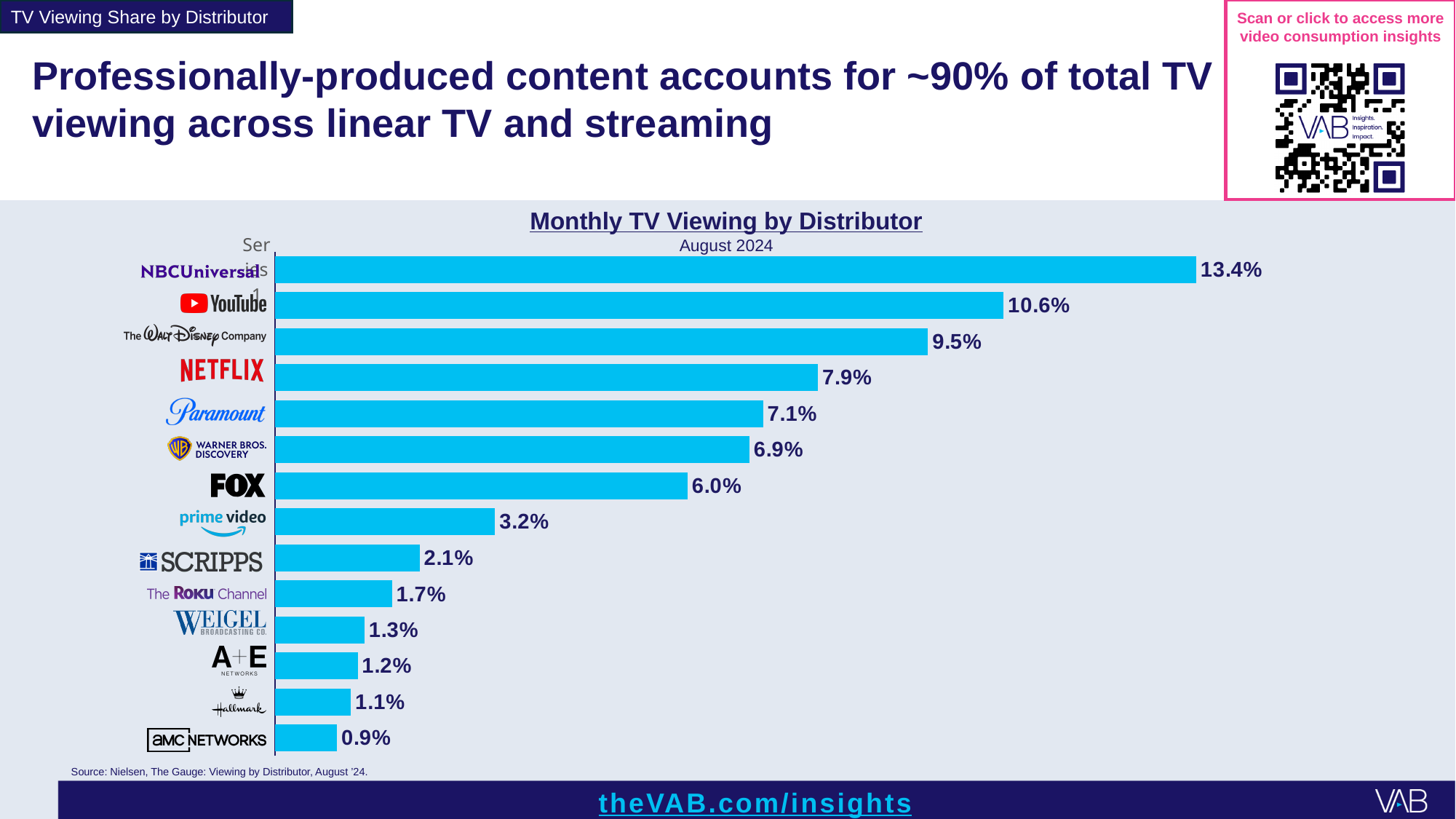
What is the monthly TV viewing share for NBCUniversal? 13.4% What is the monthly TV viewing share for Prime Video? 3.2% What month and year does the chart cover? August 2024 Which distributor has the highest monthly TV viewing share? NBCUniversal What is the difference in viewing share between YouTube and The Walt Disney Company? 1.1% What is the monthly TV viewing share for Netflix? 7.9% What type of chart is used to show monthly TV viewing by distributor? Bar chart What is the monthly TV viewing share for The Roku Channel? 1.7% How many distributors are shown in the chart? 14 What is the difference in viewing share between NBCUniversal and FOX? 7.4% Which distributor has the lowest monthly TV viewing share? AMC Networks Which has a larger viewing share, Paramount or Warner Bros. Discovery? Paramount